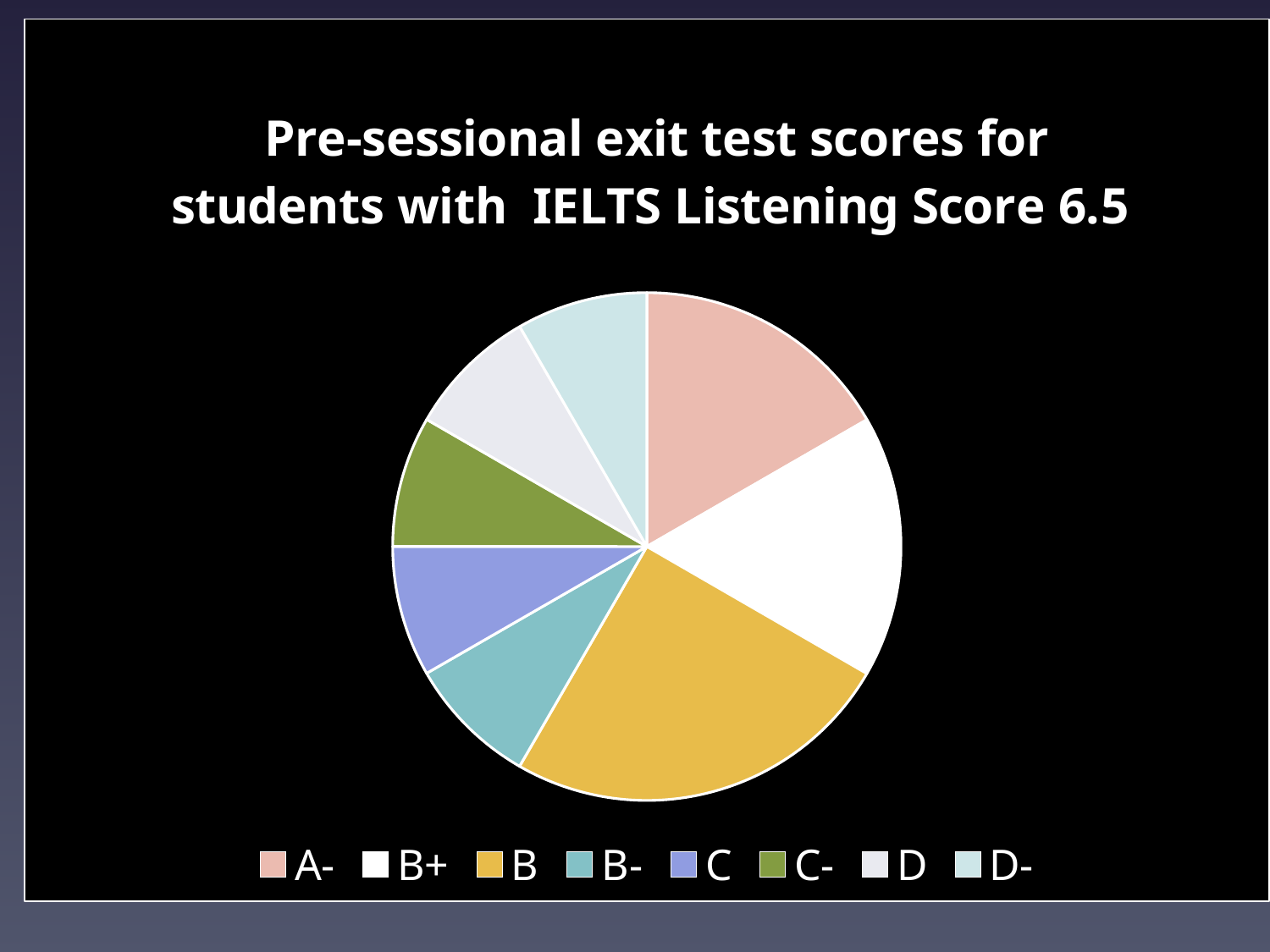
Which slice is larger, B or B+? B How many categories does the pie chart show? 8 Which slice is larger, B or B-? B Which slice is larger, B+ or C? B+ Which category has the largest slice of the pie? B Which category is shown in white in the pie chart? B+ What kind of chart is shown on the slide? pie chart What is the title of the chart? Pre-sessional exit test scores for students with IELTS Listening Score 6.5